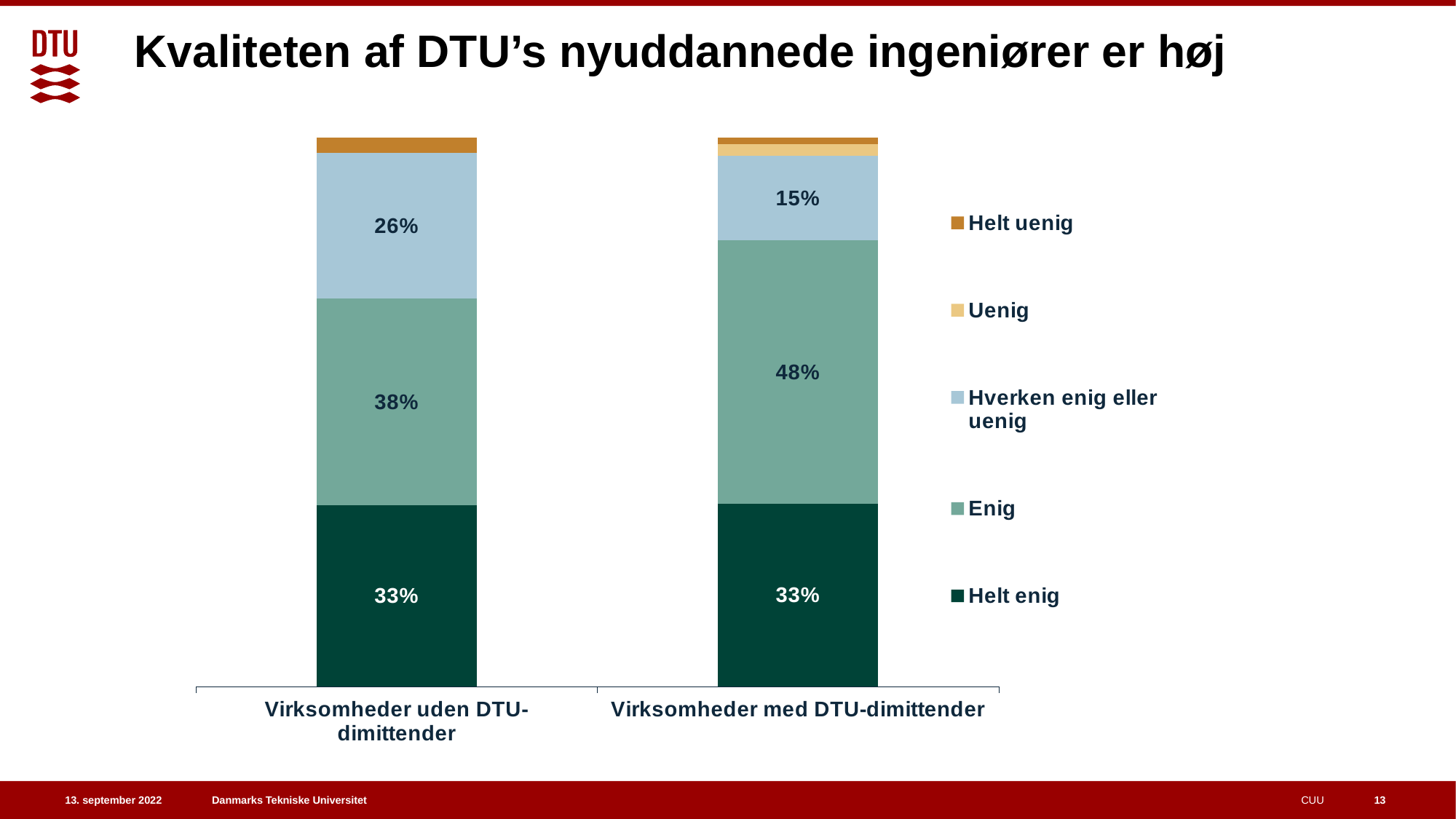
What percentage of Virksomheder uden DTU-dimittender answered Hverken enig eller uenig? 26% What percentage of Virksomheder med DTU-dimittender answered Enig? 48% What is the difference in the Hverken enig eller uenig share between Virksomheder uden DTU-dimittender and Virksomheder med DTU-dimittender? 11% How many series does the legend list? 5 What kind of chart is shown on the slide? Stacked bar chart What percentage of Virksomheder med DTU-dimittender answered Hverken enig eller uenig? 15% What percentage of Virksomheder uden DTU-dimittender answered Helt enig? 33% What is the title of the slide? Kvaliteten af DTU’s nyuddannede ingeniører er høj Which category has the larger Enig share, Virksomheder uden DTU-dimittender or Virksomheder med DTU-dimittender? Virksomheder med DTU-dimittender What percentage of Virksomheder uden DTU-dimittender answered Enig? 38% What is the difference in the Enig share between Virksomheder med DTU-dimittender and Virksomheder uden DTU-dimittender? 10% How many categories are shown on the x axis of the chart? 2